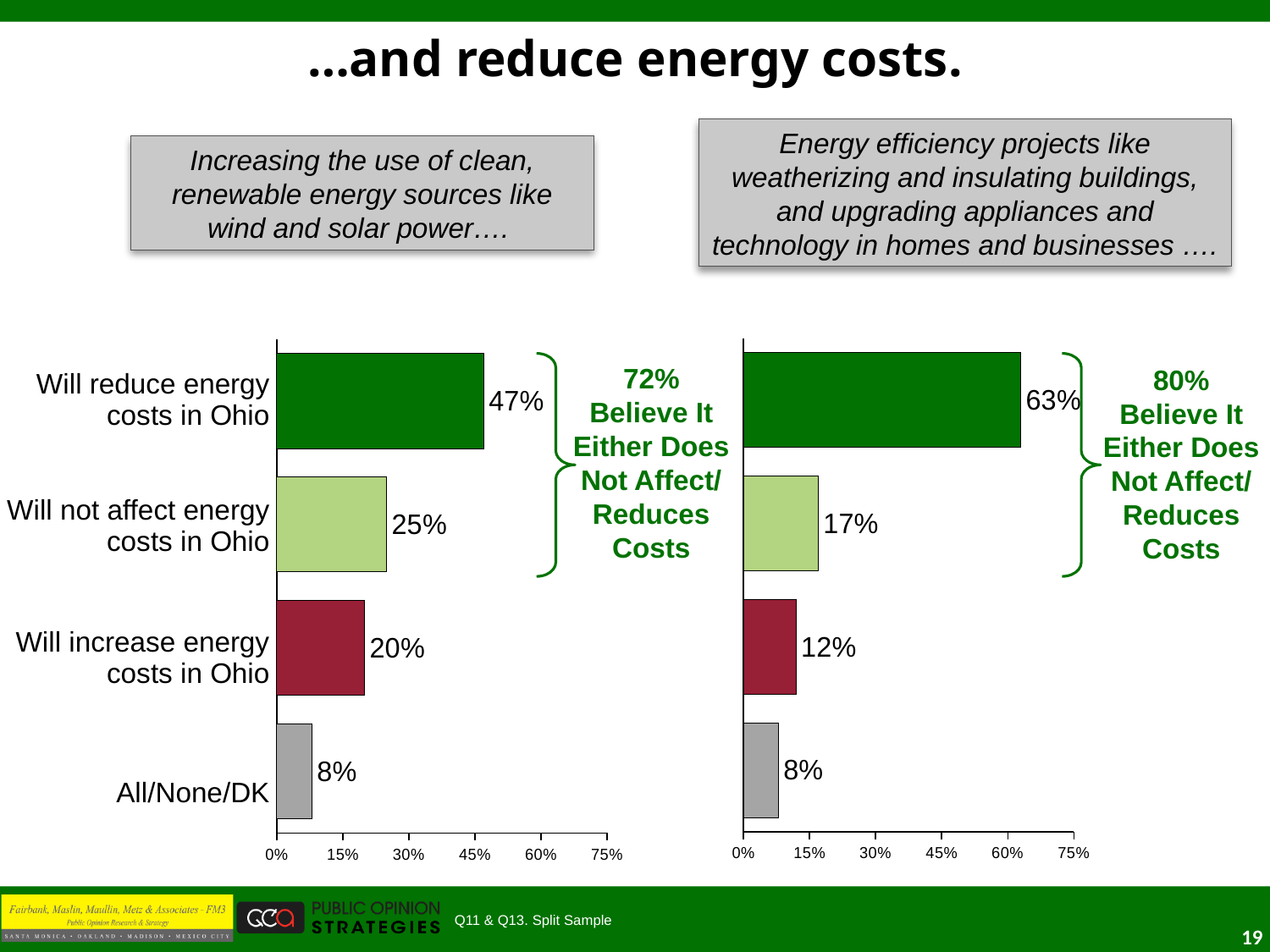
Which is larger: the 'Will reduce energy costs in Ohio' value in the left chart or in the right chart? Right chart (63%) In the right chart (energy efficiency projects), what percentage say it will reduce energy costs in Ohio? 63% What type of chart is used on this slide? Bar chart In the left chart (clean, renewable energy sources), what percentage say it will reduce energy costs in Ohio? 47% In the left chart (clean, renewable energy sources), is the value for 'Will not affect energy costs in Ohio' greater or less than 30%? less In the left chart (clean, renewable energy sources), what is the difference between 'Will reduce energy costs in Ohio' and 'Will increase energy costs in Ohio'? 27% In the left chart (clean, renewable energy sources), what percentage say it will increase energy costs in Ohio? 20% How many categories are shown in the left chart (clean, renewable energy sources)? 4 In the right chart (energy efficiency projects), what percentage say it will not affect energy costs in Ohio? 17% In the right chart (energy efficiency projects), which category has the lowest value? All/None/DK In the left chart (clean, renewable energy sources), which category has the highest value? Will reduce energy costs in Ohio In the right chart (energy efficiency projects), what percentage is stated to believe it either does not affect or reduces costs? 80%